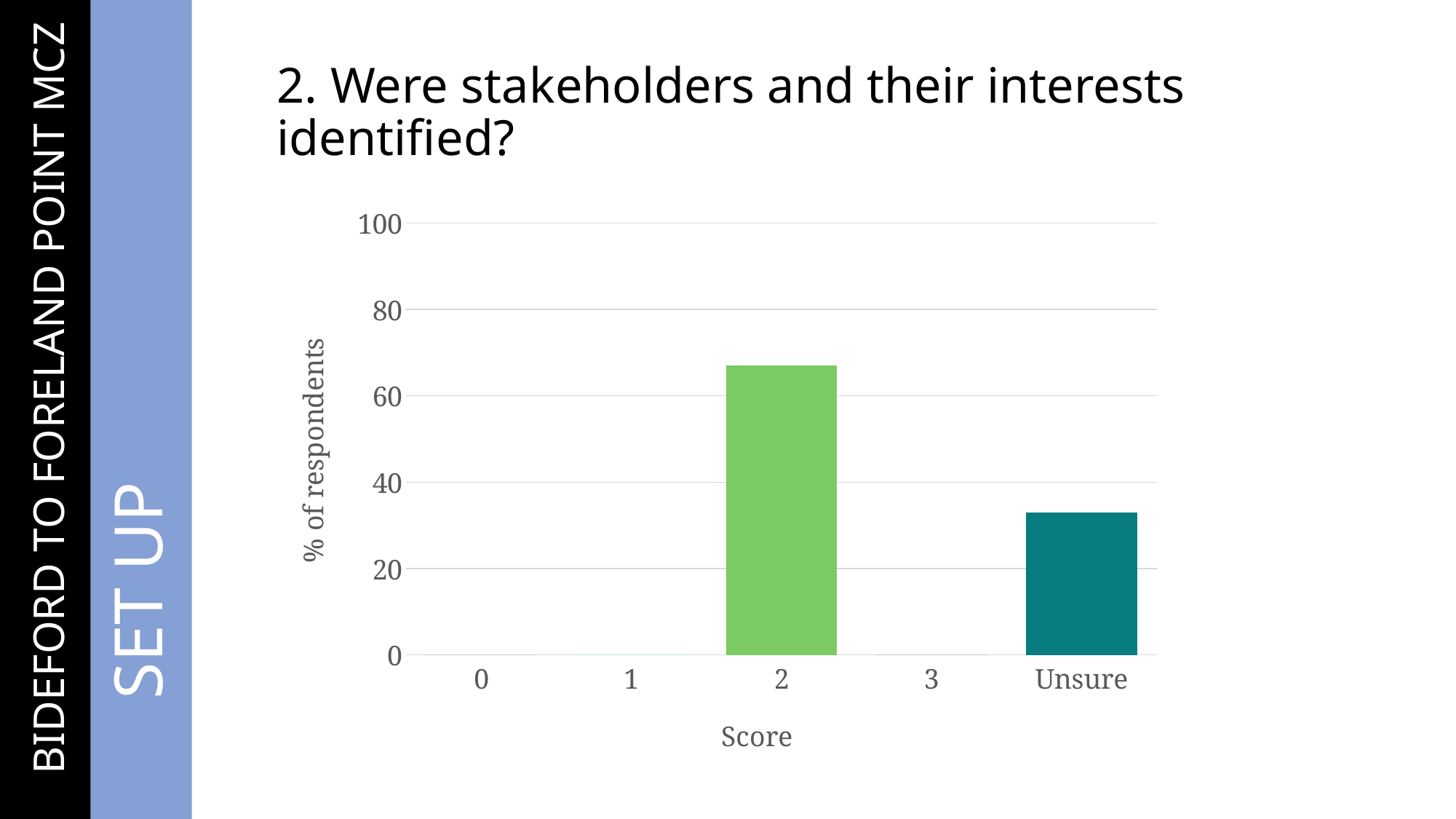
Is the value for Unsure greater or less than 20? greater What kind of chart is shown on the slide? bar chart How many score categories are shown on the x axis? 5 Is the value for score 2 greater or less than 80? less What is the label of the x axis? Score Is the value for Unsure greater or less than 40? less What is the label of the y axis? % of respondents Which has a higher percentage of respondents, score 2 or Unsure? 2 Which score category has the highest percentage of respondents? 2